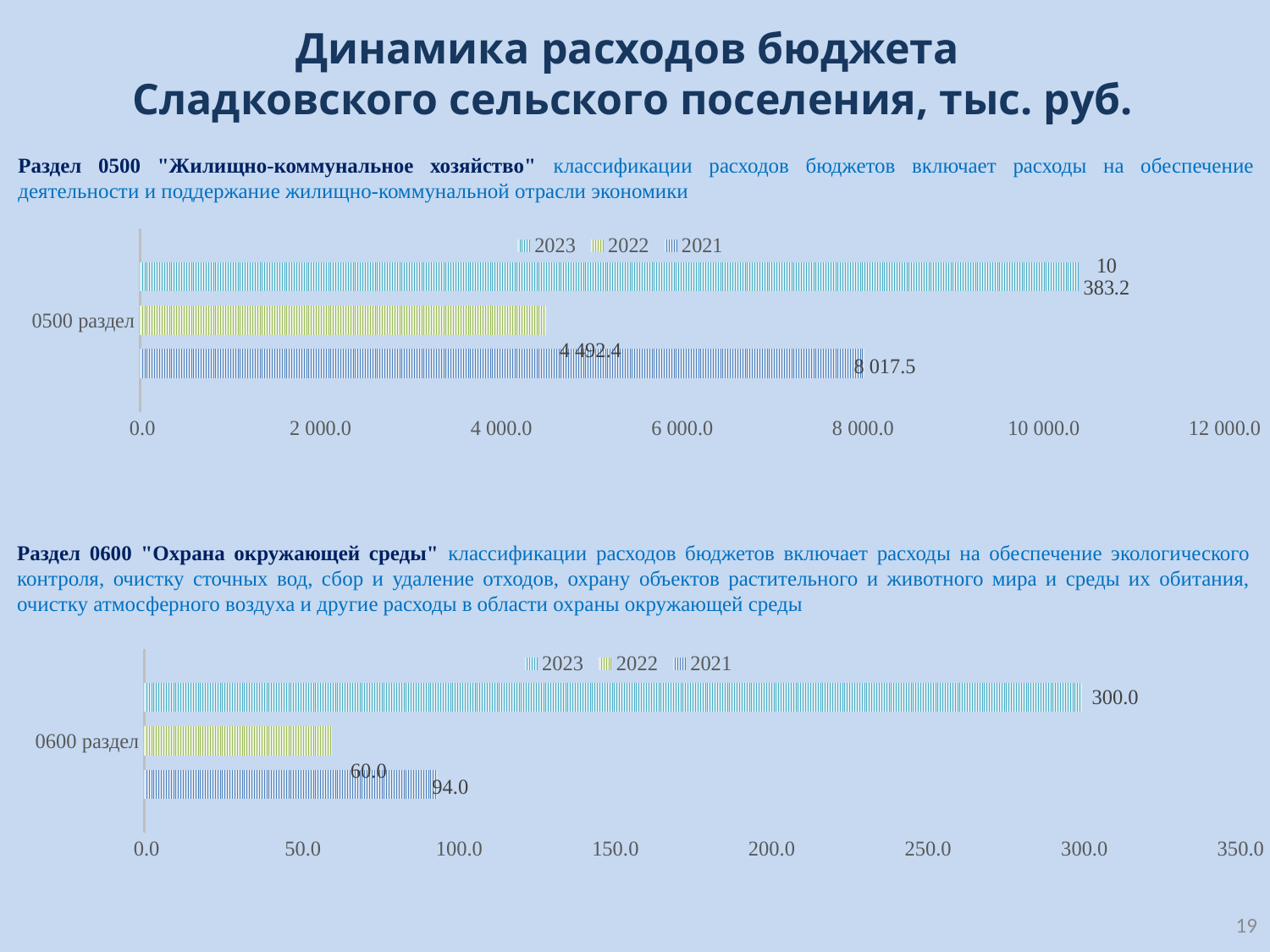
In the top chart (0500 раздел), how many series does the legend list? 3 In the top chart (0500 раздел), which year has the lowest value? 2022 In the bottom chart (0600 раздел), which year has the highest value? 2023 In the bottom chart (0600 раздел), what is the value for 2021? 94.0 In the bottom chart (0600 раздел), which is larger, the value for 2021 or the value for 2022? 2021 In the bottom chart (0600 раздел), what is the value for 2023? 300.0 In the top chart (0500 раздел), what is the value for 2023? 10 383.2 In the bottom chart (0600 раздел), what is the difference between the 2021 and 2022 values? 34.0 In the top chart (0500 раздел), what is the value for 2022? 4 492.4 In the top chart (0500 раздел), what is the difference between the 2023 and 2021 values? 2 365.7 In the top chart (0500 раздел), what is the value for 2021? 8 017.5 What kind of chart is the bottom chart (0600 раздел)? Bar chart